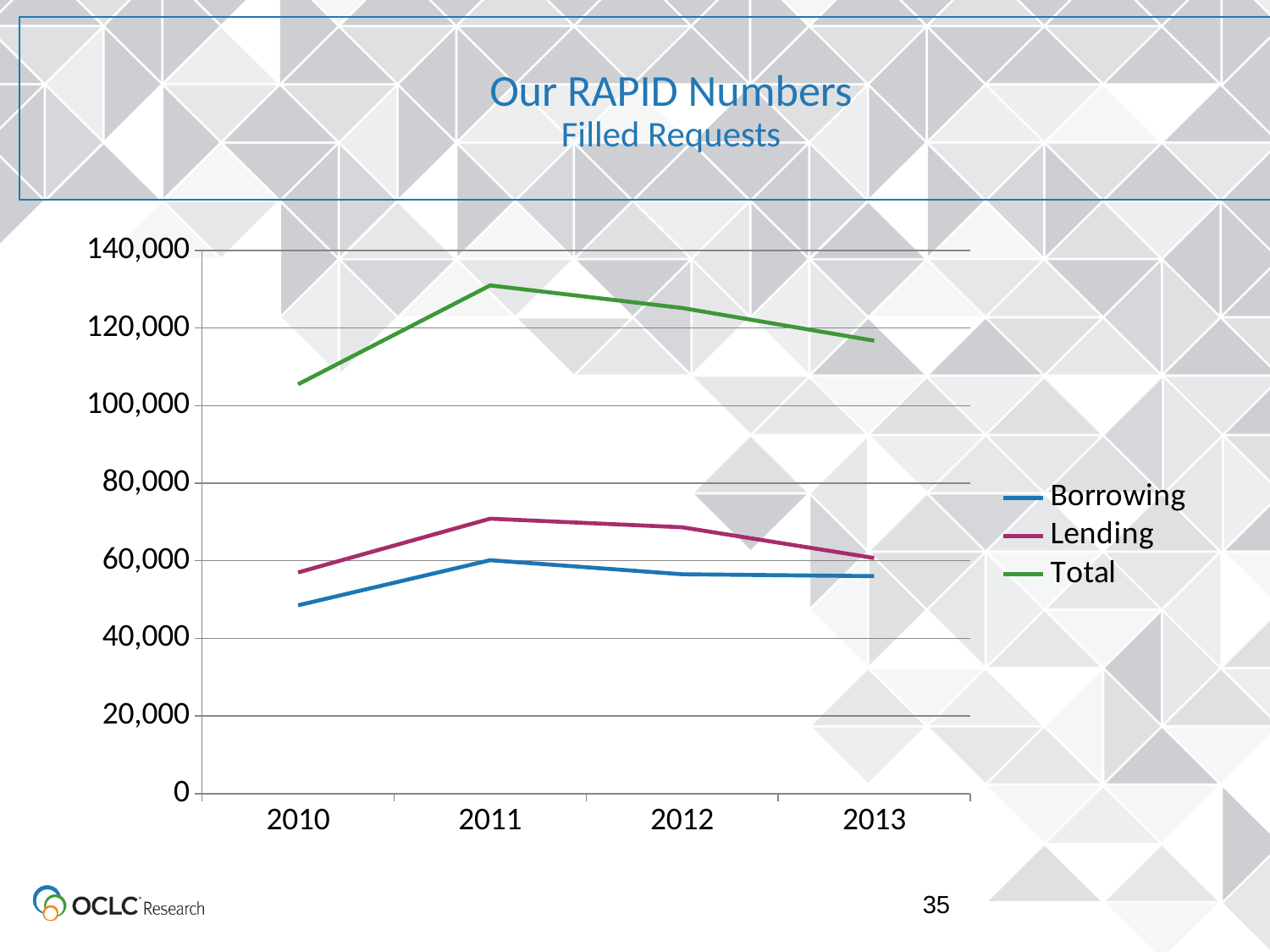
In which year is the Total line at its highest? 2011 Is the Total value for 2011 greater or less than 120,000? greater How many years are shown on the x axis? 4 In which year is the Borrowing line at its lowest? 2010 In which year is the Total line at its lowest? 2010 Which is larger, the Total value for 2012 or the Total value for 2013? 2012 What kind of chart is shown on the slide? Line chart Is the Borrowing value for 2010 greater or less than 60,000? less Does the Total line rise or fall from 2011 to 2013? Fall Is the Lending value for 2011 greater or less than 60,000? greater What is the subtitle of the chart shown on the slide? Filled Requests How many series does the legend list? 3